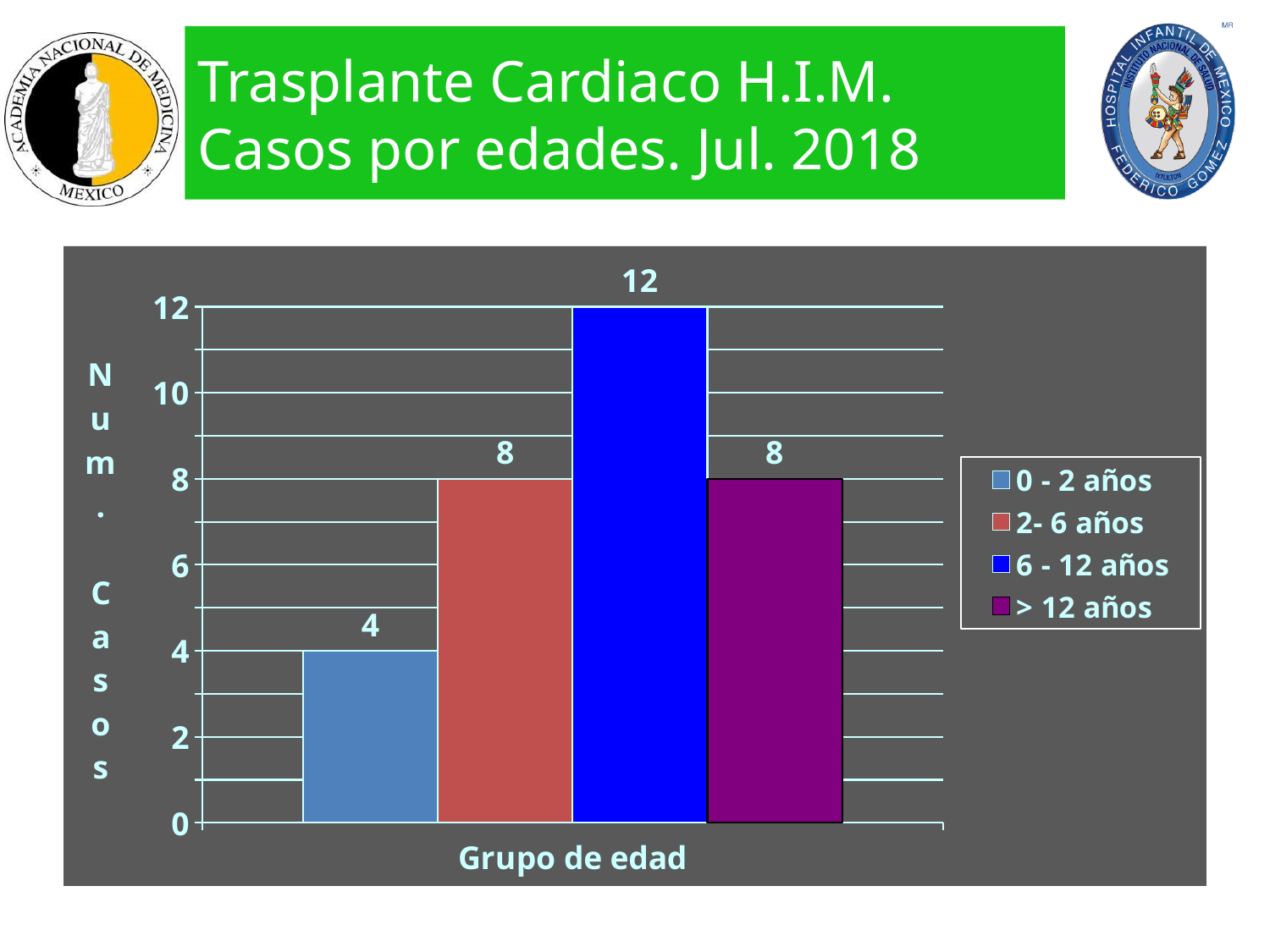
What is the difference in cases between the 6 - 12 años group and the 0 - 2 años group? 8 How many cases are shown for the 6 - 12 años group? 12 What kind of chart is shown on the slide? bar chart How many entries does the legend list? 4 Which age group has the highest number of cases? 6 - 12 años How many age groups are plotted in the chart? 4 How many cases are shown for the > 12 años group? 8 Which group has more cases, 2- 6 años or 0 - 2 años? 2- 6 años Is the value for 6 - 12 años greater or less than 10? greater Which age group has the lowest number of cases? 0 - 2 años How many cases are shown for the 0 - 2 años group? 4 What is the label of the x axis? Grupo de edad